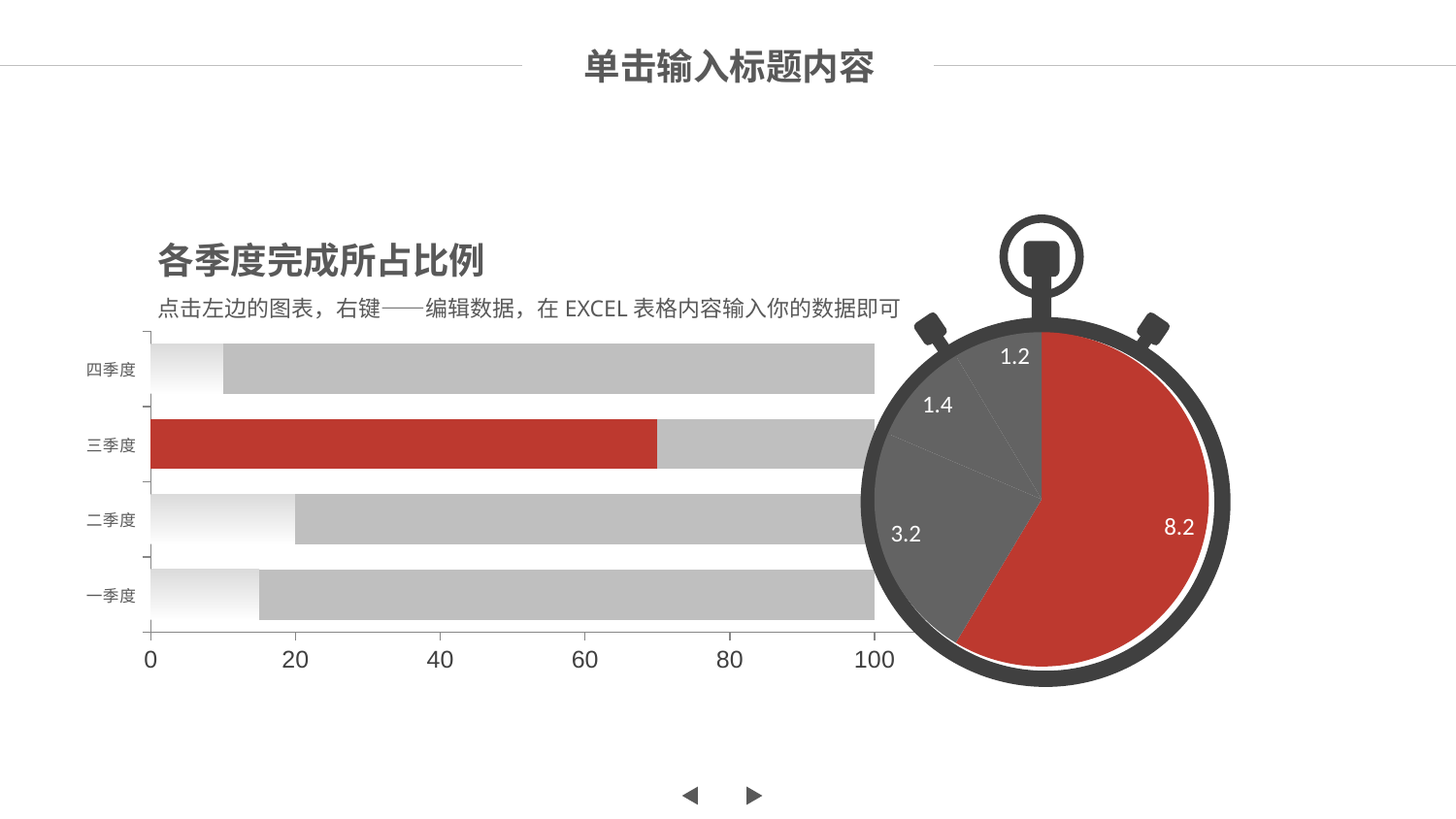
In the bar chart on the left, which quarter is shown with a red bar? 三季度 What kind of chart is shown inside the stopwatch on the right? pie chart In the bar chart on the left, is the value for 四季度 greater or less than 20? less In the pie chart on the right, what is the largest slice value? 8.2 What is the title of the bar chart on the left? 各季度完成所占比例 In the bar chart on the left, how many quarter categories are shown? 4 In the bar chart on the left, is the value for 一季度 greater or less than 20? less What kind of chart is the chart on the left of the slide? bar chart In the bar chart on the left, which quarter has the highest value? 三季度 In the pie chart on the right, what is the smallest slice value? 1.2 In the pie chart on the right, how many slices are there? 4 In the bar chart on the left, is the red value for 三季度 greater or less than 60? greater